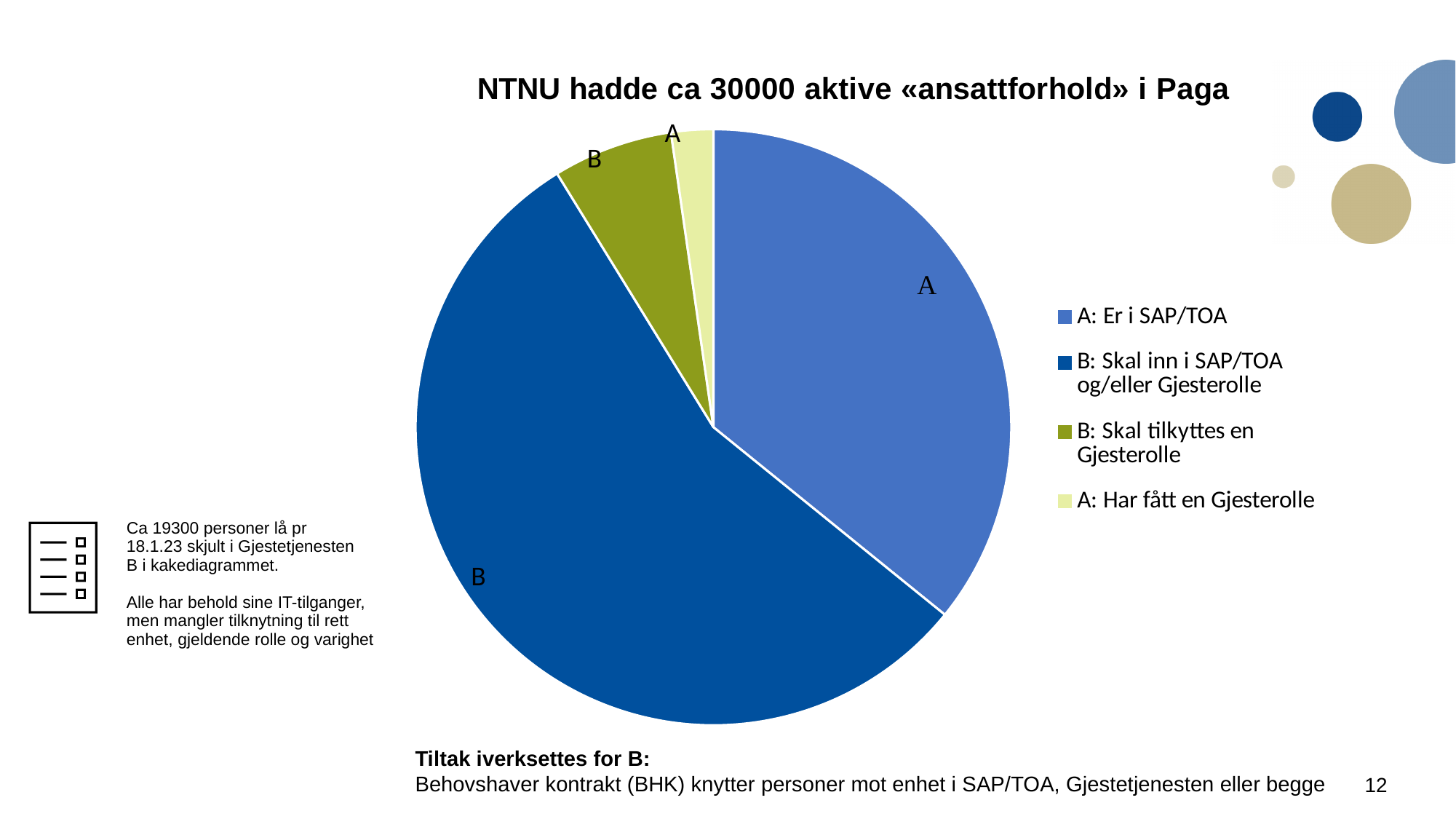
What is the title of the pie chart? NTNU hadde ca 30000 aktive «ansattforhold» i Paga Which slice is larger: "B: Skal tilkyttes en Gjesterolle" or "A: Har fått en Gjesterolle"? B: Skal tilkyttes en Gjesterolle Which slice is larger: "A: Er i SAP/TOA" or "B: Skal inn i SAP/TOA og/eller Gjesterolle"? B: Skal inn i SAP/TOA og/eller Gjesterolle How many slices does the pie chart have? 4 How many entries does the legend of the pie chart list? 4 Which category has the smallest slice of the pie chart? A: Har fått en Gjesterolle What colour is the slice for "B: Skal tilkyttes en Gjesterolle" in the pie chart? olive green Which category has the largest slice of the pie chart? B: Skal inn i SAP/TOA og/eller Gjesterolle What kind of chart is shown on the slide? pie chart